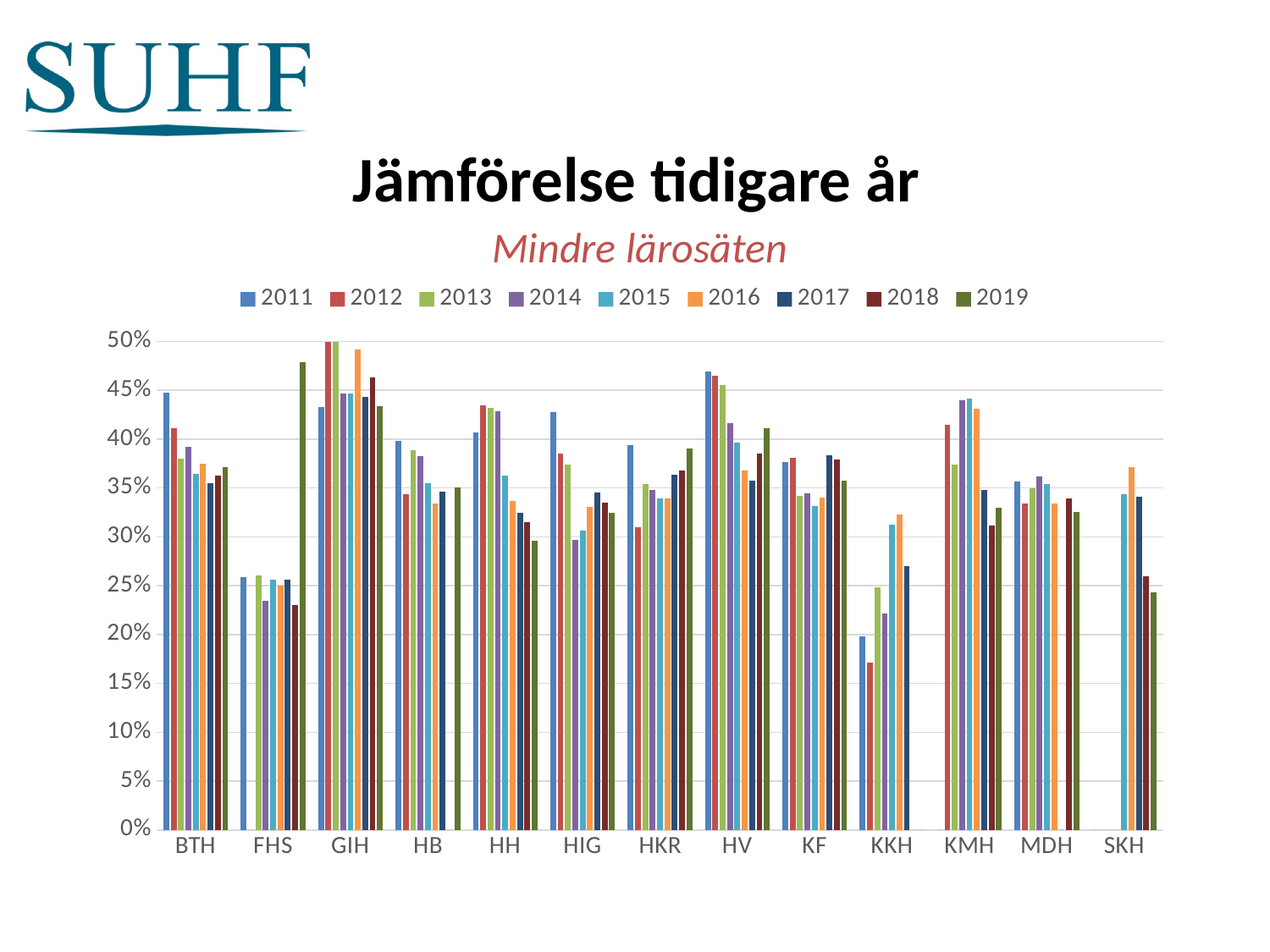
Which years does the legend cover, from first to last? 2011 to 2019 Which is larger, the 2011 value for FHS or the 2011 value for GIH? GIH How many institutions (categories) are shown on the x axis? 13 What kind of chart is shown on the slide? bar chart Is the value for KKH in 2014 greater or less than 20%? greater Is the value for KMH in 2013 greater or less than 35%? greater What is the subtitle shown in red italics below the chart title? Mindre lärosäten Is the value for KKH in 2012 greater or less than 20%? less Which year has the lowest value for KKH? 2012 How many series does the legend list? 9 Which year has the highest value for FHS? 2019